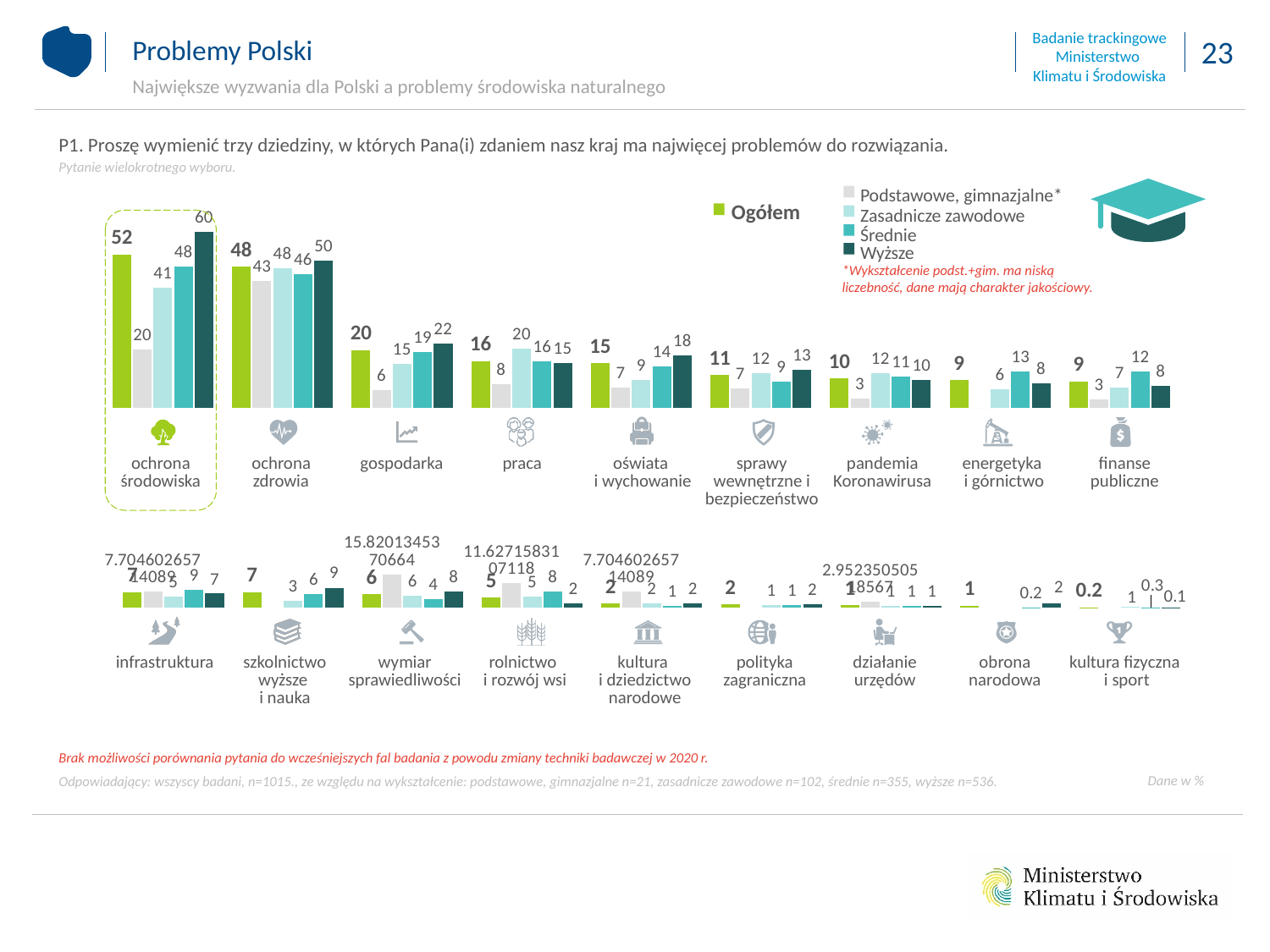
How many categories are shown in the top chart? 9 In the top chart, what is the Ogółem value for ochrona środowiska? 52 In the top chart, what is the Wyższe value for ochrona środowiska? 60 In the top chart, what is the Średnie value for finanse publiczne? 12 In the bottom chart, what is the Ogółem value for wymiar sprawiedliwości? 6 How many series does the legend list? 5 In the top chart, what is the difference between the Wyższe and Podstawowe, gimnazjalne values for ochrona środowiska? 40 In the top chart, what is the Podstawowe, gimnazjalne value for ochrona zdrowia? 43 In the top chart, which is larger for praca: the Zasadnicze zawodowe value or the Wyższe value? Zasadnicze zawodowe What type of chart is used on this slide? bar chart In the bottom chart, what is the Ogółem value for kultura fizyczna i sport? 0.2 In the top chart, which category has the highest Ogółem value? ochrona środowiska